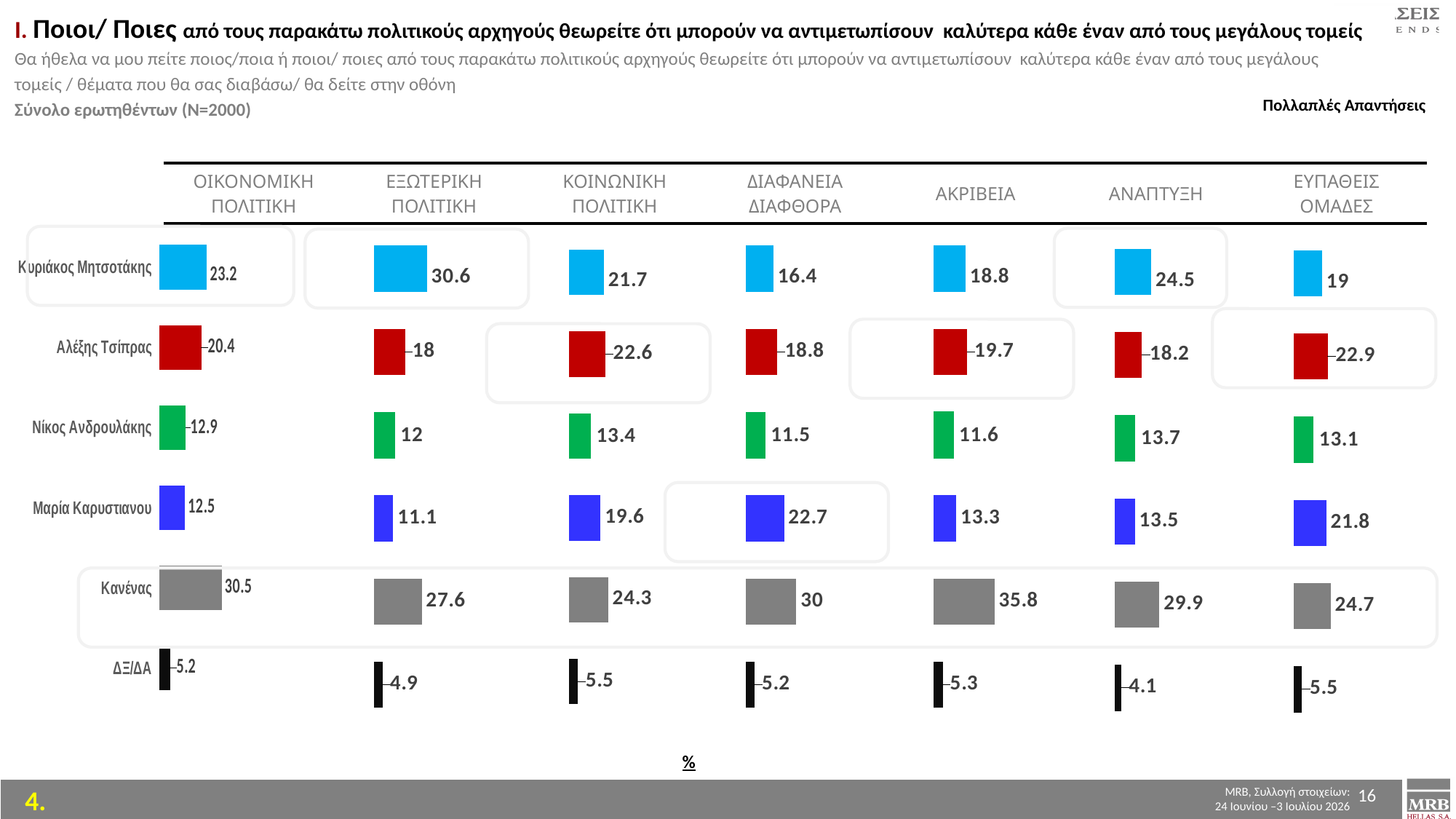
How many rows (response options) are shown in the chart? 6 In the ΑΝΑΠΤΥΞΗ column, which row has the lowest value? ΔΞ/ΔΑ In the ΕΥΠΑΘΕΙΣ ΟΜΑΔΕΣ column, what is the value for Αλέξης Τσίπρας? 22.9 In the ΕΞΩΤΕΡΙΚΗ ΠΟΛΙΤΙΚΗ column, what is the value for Κυριάκος Μητσοτάκης? 30.6 In the ΔΙΑΦΑΝΕΙΑ ΔΙΑΦΘΟΡΑ column, who has the larger value: Κυριάκος Μητσοτάκης or Μαρία Καρυστιανού? Μαρία Καρυστιανού How many sector columns are shown in the chart? 7 In the ΑΚΡΙΒΕΙΑ column, what is the value for Κανένας? 35.8 In the ΔΙΑΦΑΝΕΙΑ ΔΙΑΦΘΟΡΑ column, what is the value for Μαρία Καρυστιανού? 22.7 Among the political leaders (excluding Κανένας and ΔΞ/ΔΑ), who has the highest value in the ΚΟΙΝΩΝΙΚΗ ΠΟΛΙΤΙΚΗ column? Αλέξης Τσίπρας What is the difference between the values for Κανένας and Κυριάκος Μητσοτάκης in the ΟΙΚΟΝΟΜΙΚΗ ΠΟΛΙΤΙΚΗ column? 7.3 In which column does Κυριάκος Μητσοτάκης have his highest value? ΕΞΩΤΕΡΙΚΗ ΠΟΛΙΤΙΚΗ What kind of chart is used on this slide? Bar chart